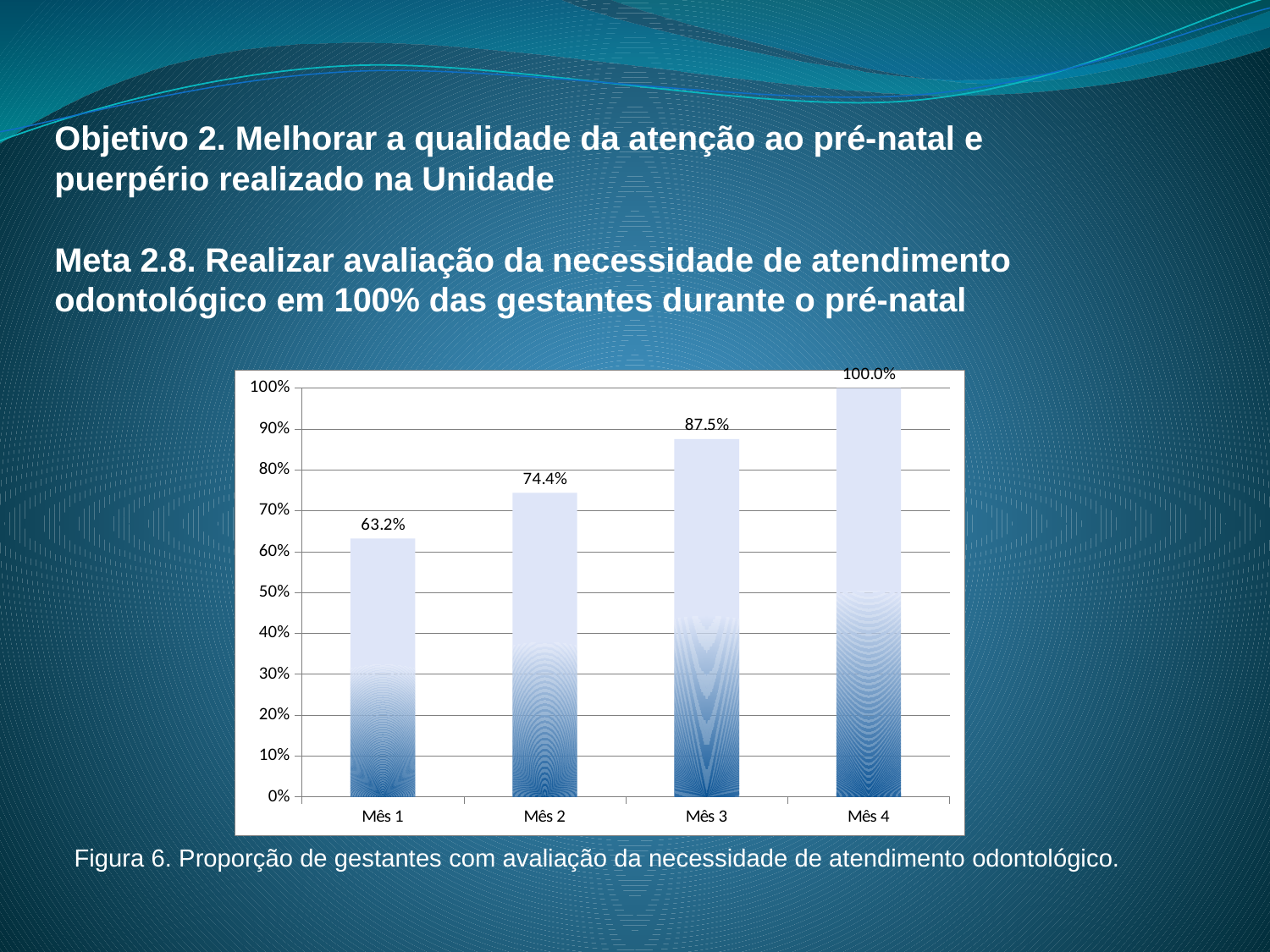
Which month has the lowest value? Mês 1 What kind of chart is shown on the slide? Bar chart How many months are shown on the x axis? 4 What is the difference between the values for Mês 2 and Mês 1? 11.2% What is the value for Mês 1? 63.2% Do the values rise or fall from Mês 1 to Mês 4? Rise Is the value for Mês 2 greater or less than 70%? greater Which is larger, the value for Mês 2 or the value for Mês 3? Mês 3 What is the value for Mês 4? 100.0% What is the difference between the values for Mês 4 and Mês 3? 12.5% Which month has the highest value? Mês 4 What is the value for Mês 3? 87.5%